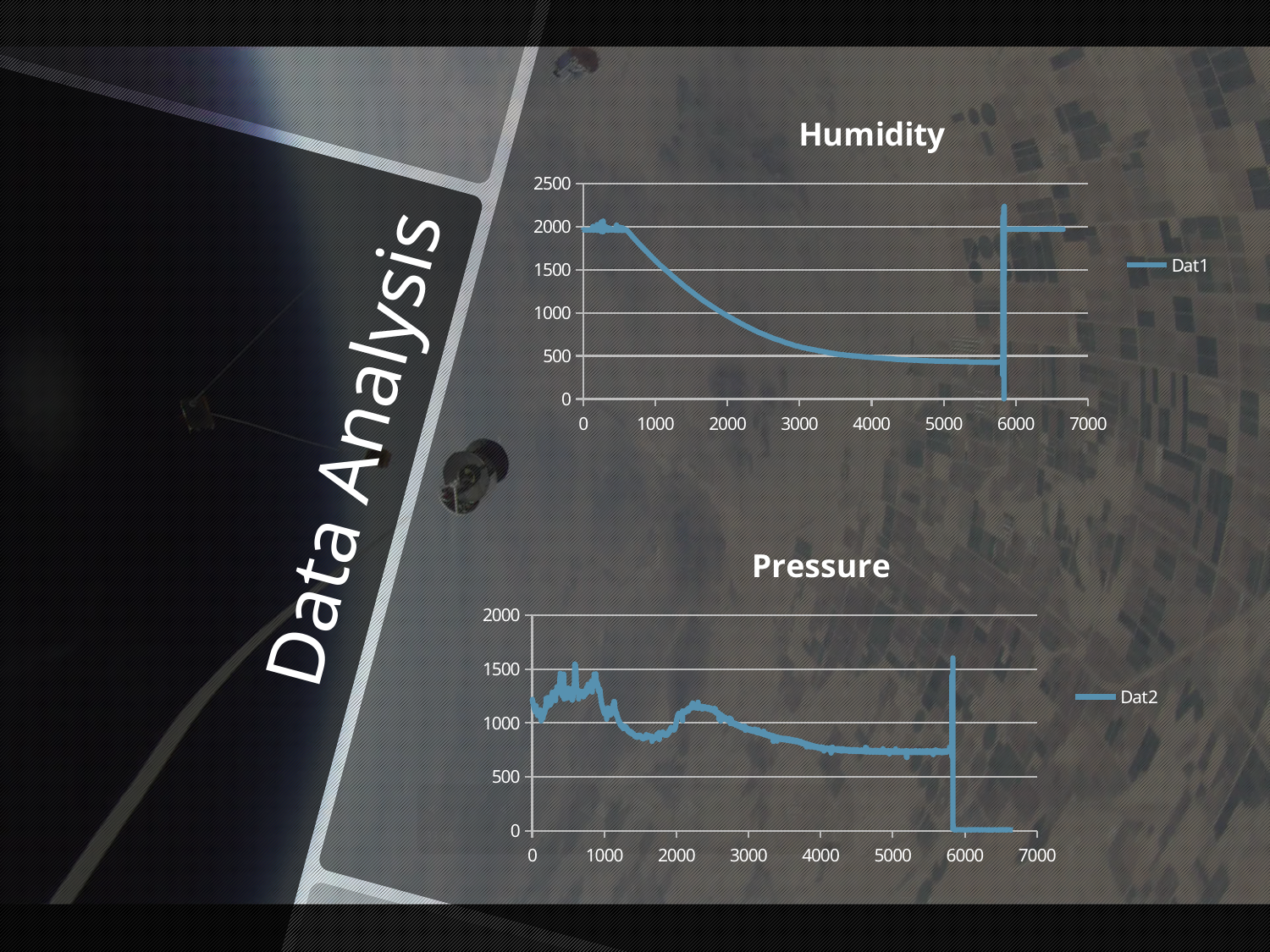
How many series does the legend of the Humidity chart list? 1 In the Humidity chart, do the values rise or fall between x = 1000 and x = 5000? fall In the Pressure chart, is the value at x = 500 greater or less than 1000? greater In the Pressure chart, is the value at x = 6500 greater or less than 500? less In the Humidity chart, is the value at x = 500 greater or less than 1500? greater What is the legend entry for the series in the Pressure chart? Dat2 In the Pressure chart, do the values rise or fall between x = 3000 and x = 5000? fall What kind of chart is the Humidity chart? line chart What is the legend entry for the series in the Humidity chart? Dat1